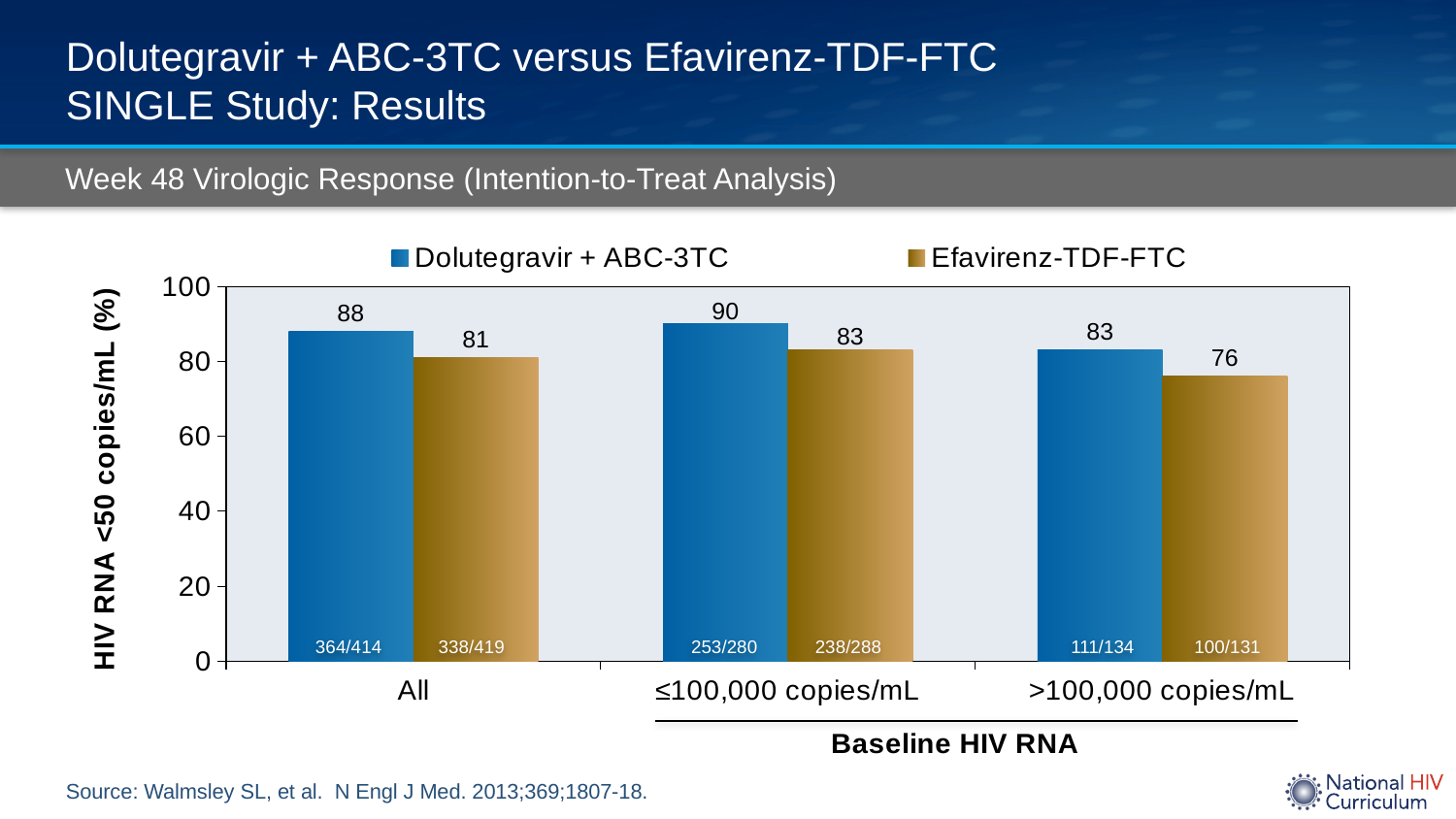
What is the value for Dolutegravir + ABC-3TC in the All category? 88 What is the difference between Dolutegravir + ABC-3TC and Efavirenz-TDF-FTC in the >100,000 copies/mL category? 7 Which category has the highest value for Dolutegravir + ABC-3TC? ≤100,000 copies/mL In the ≤100,000 copies/mL category, which series has the larger value? Dolutegravir + ABC-3TC What is the value for Efavirenz-TDF-FTC in the ≤100,000 copies/mL category? 83 Which category has the lowest value for Efavirenz-TDF-FTC? >100,000 copies/mL What kind of chart is shown on the slide? Bar chart What fraction is printed inside the Dolutegravir + ABC-3TC bar for the All category? 364/414 What is the value for Efavirenz-TDF-FTC in the >100,000 copies/mL category? 76 How many series does the legend list? 2 How many categories are shown on the x axis? 3 What is the difference between Dolutegravir + ABC-3TC and Efavirenz-TDF-FTC in the All category? 7